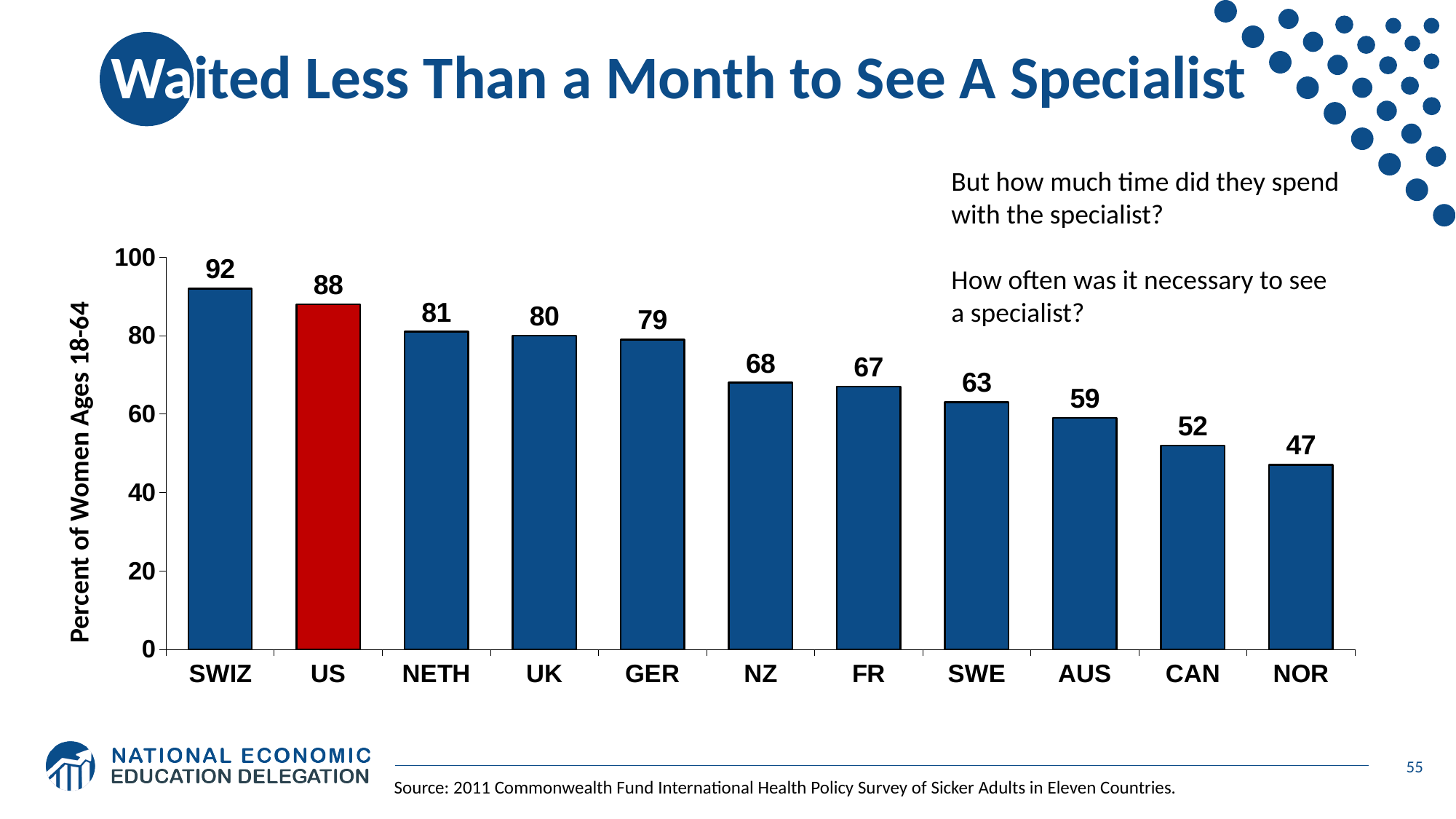
Which bar is coloured red rather than blue? US How many countries are shown on the x axis? 11 Which is larger, the value for NZ or the value for SWE? NZ What is the value for NOR? 47 What is the value for GER? 79 What is the difference between the values for SWIZ and the US? 4 Which country has the lowest value? NOR What is the value for the US? 88 Which country has the highest value? SWIZ Is the value for AUS greater or less than 60? less What is the difference between the values for NETH and CAN? 29 What kind of chart is shown on the slide? bar chart